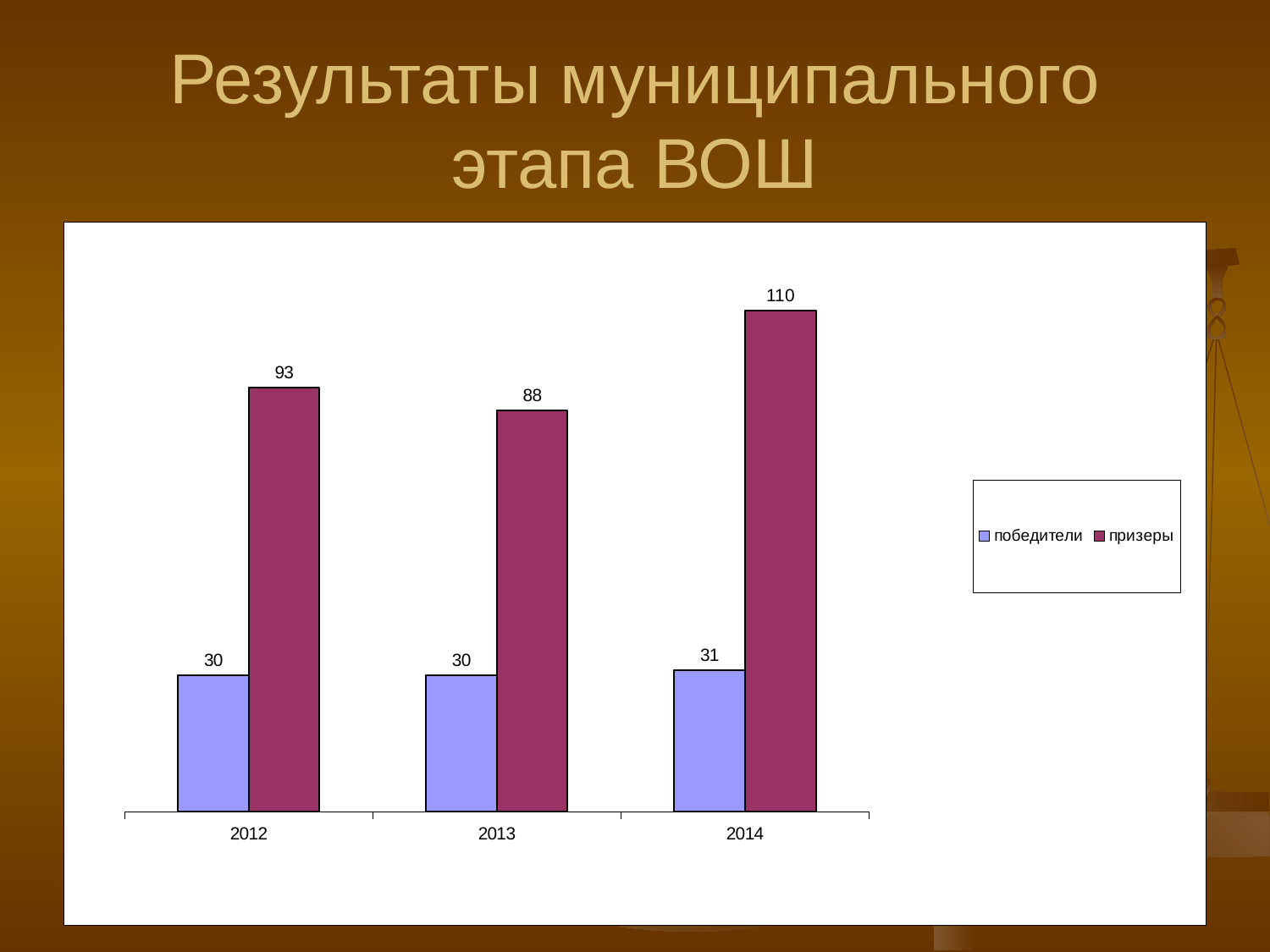
What kind of chart is shown on the slide? bar chart In which year is the value for призеры lowest? 2013 What is the value for победители in 2014? 31 What is the value for победители in 2012? 30 How many years are shown on the x axis? 3 What is the difference between the призеры values for 2014 and 2013? 22 How many series does the legend list? 2 In which year is the value for призеры highest? 2014 What is the value for призеры in 2013? 88 What is the difference between призеры and победители in 2012? 63 Which is larger: призеры in 2012 or призеры in 2013? призеры in 2012 What is the value for призеры in 2014? 110